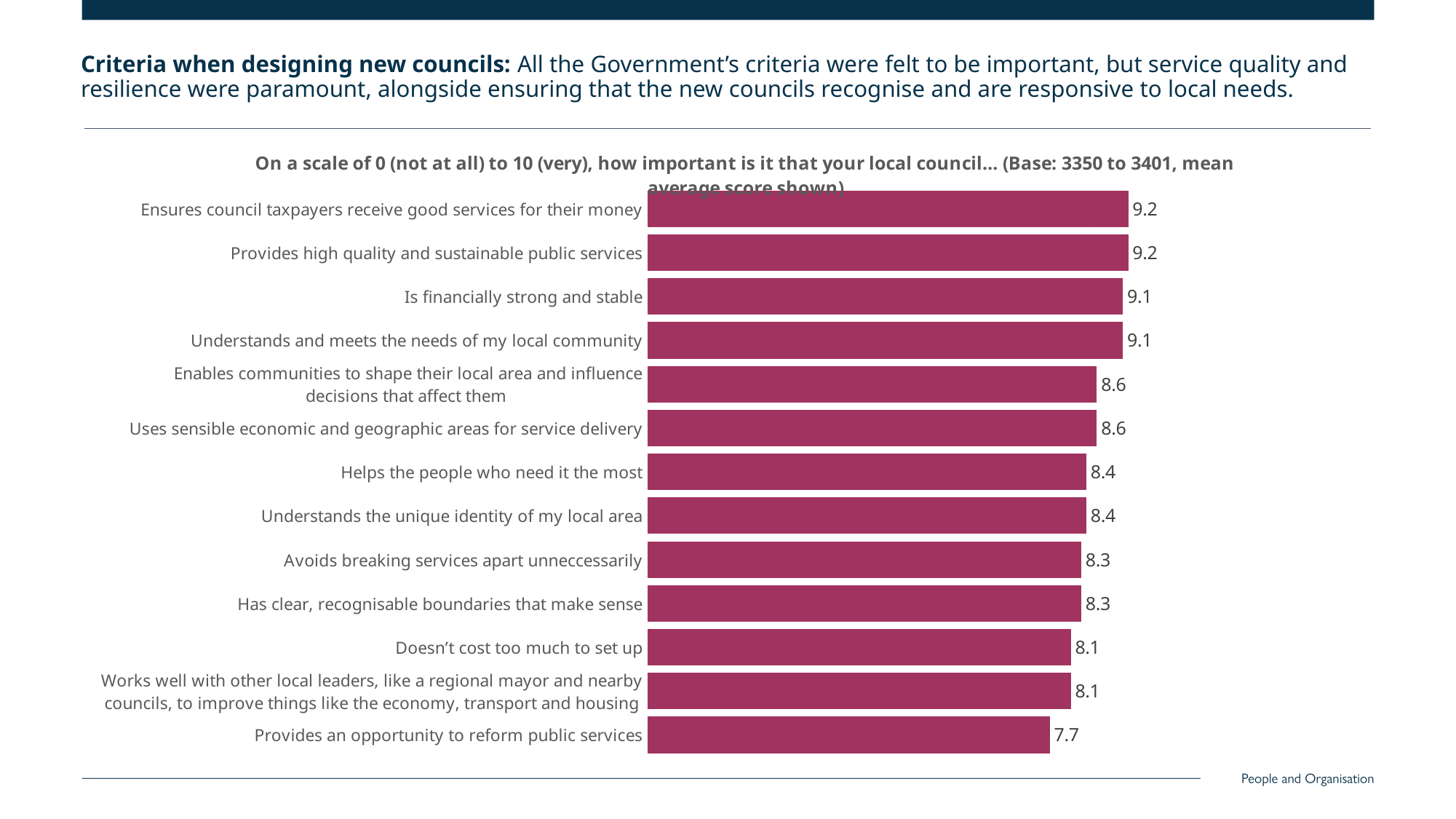
How many criteria are shown in the chart? 13 What is the mean score for 'Is financially strong and stable'? 9.1 Do the mean scores increase or decrease from the top bar to the bottom bar? Decrease What is the mean score for 'Provides an opportunity to reform public services'? 7.7 Which has a higher mean score: 'Understands and meets the needs of my local community' or 'Avoids breaking services apart unneccessarily'? Understands and meets the needs of my local community What is the difference between the mean scores for 'Uses sensible economic and geographic areas for service delivery' and 'Has clear, recognisable boundaries that make sense'? 0.3 What is the mean score for 'Helps the people who need it the most'? 8.4 What is the highest mean score shown in the chart? 9.2 Which criterion has the lowest mean score? Provides an opportunity to reform public services What type of chart is shown on the slide? Bar chart What is the mean score for 'Doesn't cost too much to set up'? 8.1 What is the difference between the mean scores for 'Ensures council taxpayers receive good services for their money' and 'Provides an opportunity to reform public services'? 1.5